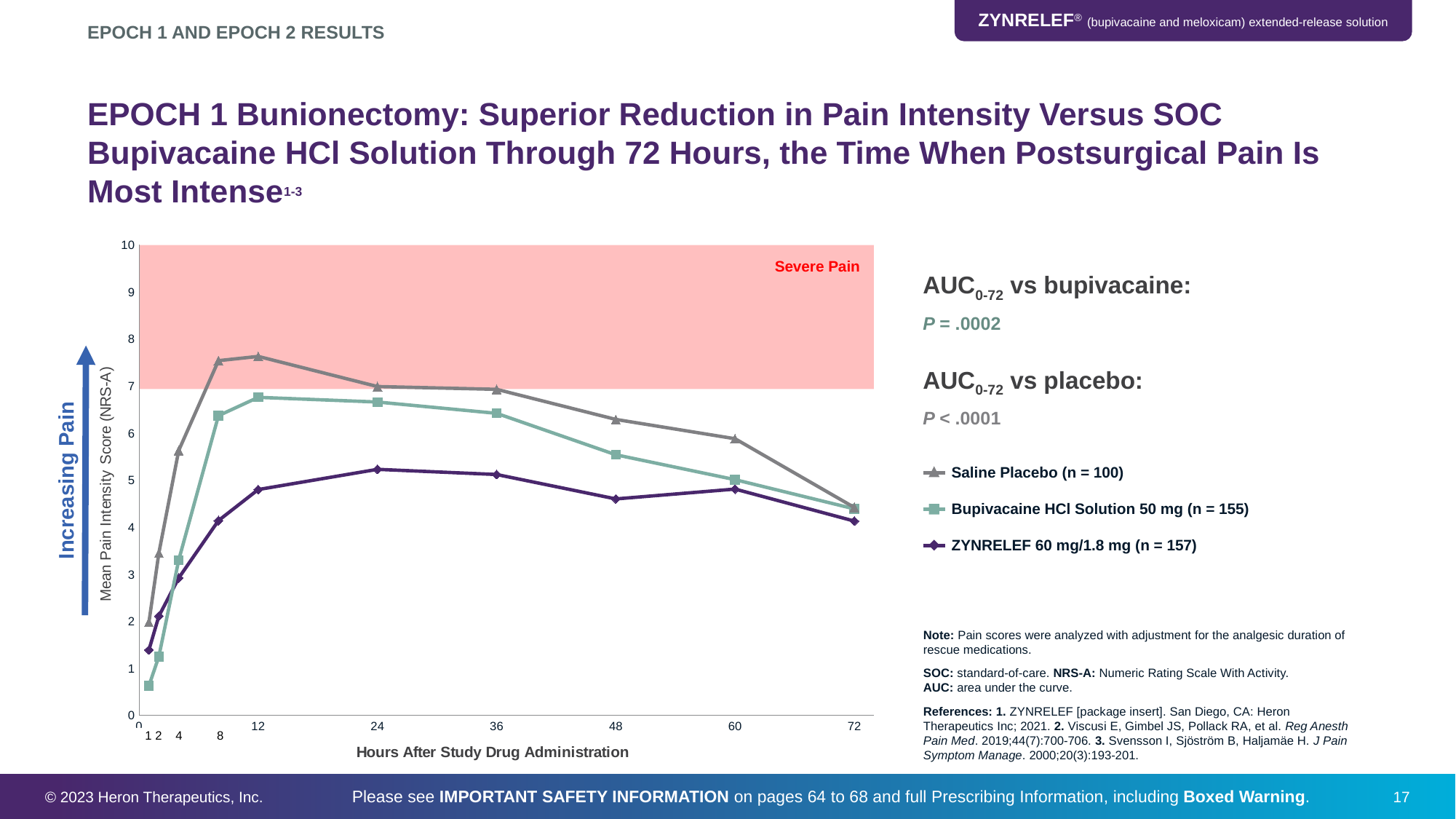
At 12 hours, which is higher: Saline Placebo or ZYNRELEF 60 mg/1.8 mg? Saline Placebo From 12 hours to 72 hours, does the Saline Placebo line rise or fall? fall How many series does the legend list? 3 What kind of chart is shown on the slide? line chart Which series has the highest mean pain intensity score at 8 hours? Saline Placebo Is the value for ZYNRELEF 60 mg/1.8 mg at 24 hours greater or less than 6? less Which series has the lowest mean pain intensity score at 48 hours? ZYNRELEF 60 mg/1.8 mg How many time points are labeled on the x axis? 10 Which series in the legend has n = 157? ZYNRELEF 60 mg/1.8 mg What is the title of the x axis? Hours After Study Drug Administration Is the value for Saline Placebo at 12 hours greater or less than 7? greater Is the value for Bupivacaine HCl Solution 50 mg at 72 hours greater or less than 5? less